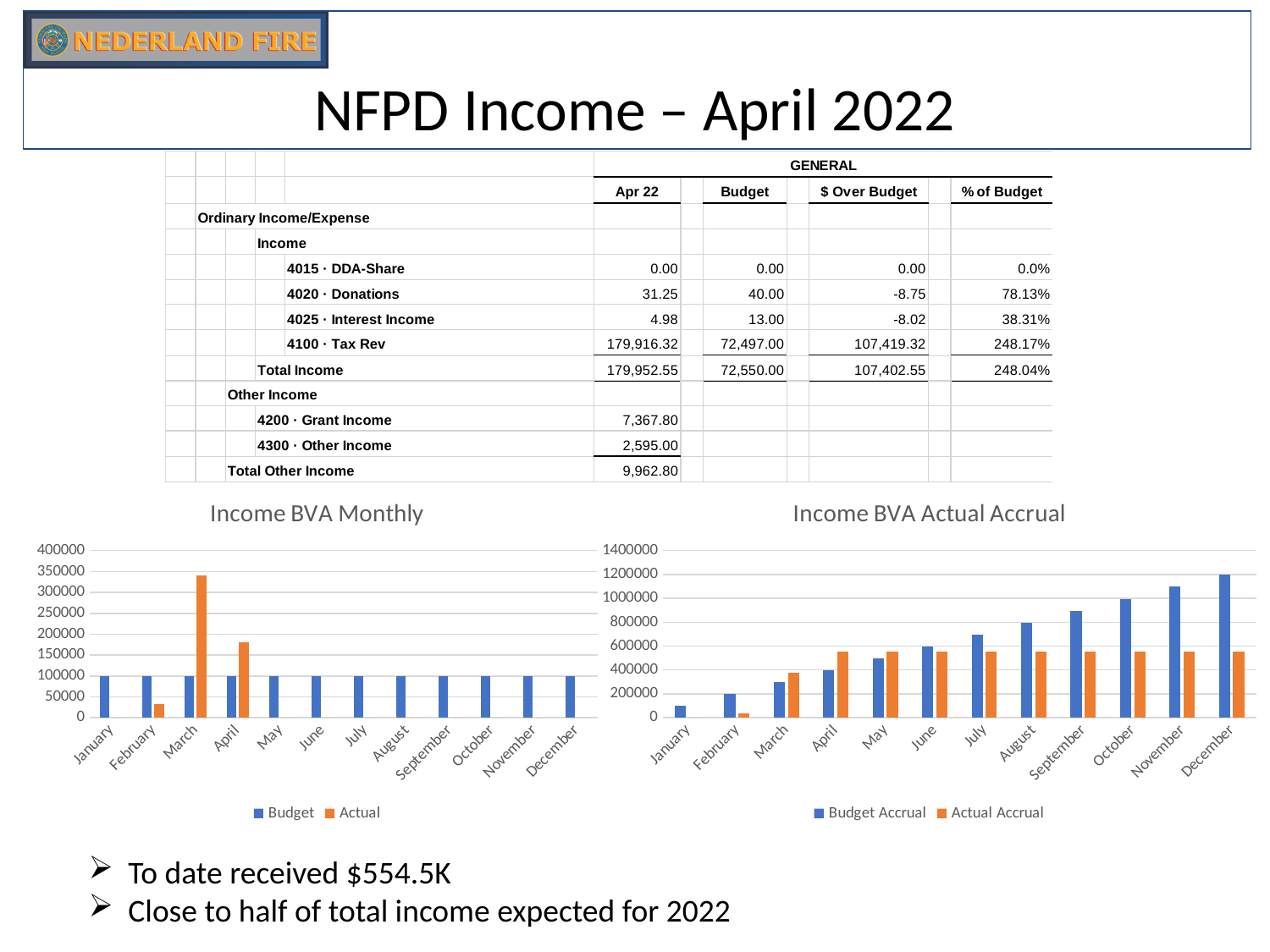
In the Income BVA Monthly chart, which is larger for April, Budget or Actual? Actual In the Income BVA Monthly chart, which month has the highest Actual value? March What kind of chart is the Income BVA Monthly chart? bar chart In the Income BVA Monthly chart, is the Actual value for February greater or less than 50000? less In the Income BVA Actual Accrual chart, do the Budget Accrual values rise or fall from January to December? rise In the Income BVA Monthly chart, is the Actual value for March greater or less than 300000? greater How many series does the legend of the Income BVA Actual Accrual chart list? 2 How many months are shown on the x axis of the Income BVA Monthly chart? 12 What are the two legend entries of the Income BVA Monthly chart? Budget and Actual In the Income BVA Actual Accrual chart, which month has the highest Budget Accrual value? December In the Income BVA Actual Accrual chart, which is larger for March, Budget Accrual or Actual Accrual? Actual Accrual In the Income BVA Actual Accrual chart, is the Budget Accrual value for December greater or less than 1000000? greater